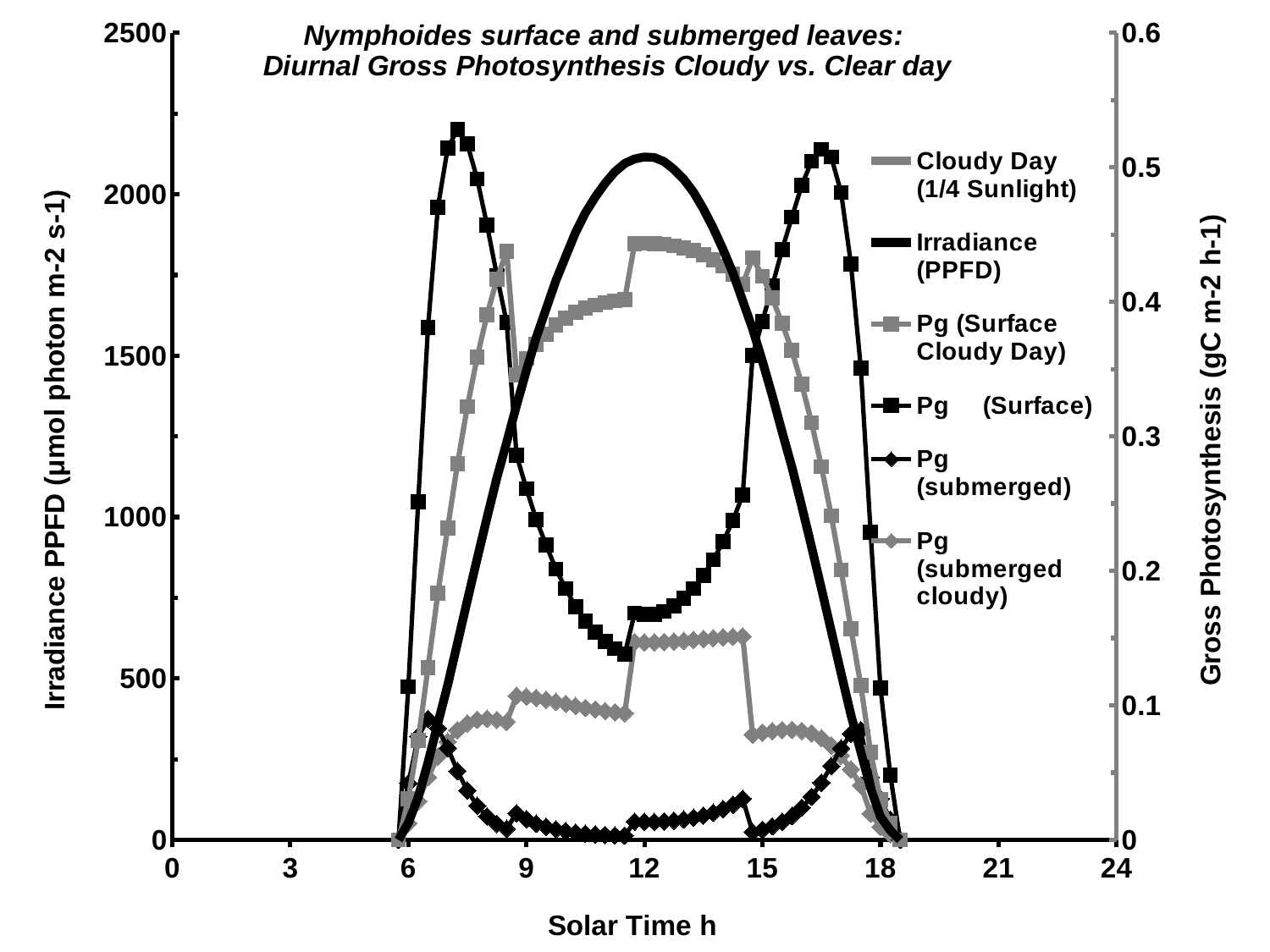
Is the peak value of the Pg (Surface) series on the right axis greater or less than 0.5? greater Is the peak value of the Cloudy Day (1/4 Sunlight) series greater or less than 1000? less At 12 h, which is higher: Pg (Surface Cloudy Day) or Pg (Surface)? Pg (Surface Cloudy Day) Between 12 h and 18 h, does the Irradiance (PPFD) series rise or fall? fall Is the value of Pg (submerged) at 10.5 h greater or less than 0.1? less What kind of chart is shown on the slide? line chart How many series does the legend list? 6 What is the title of the chart? Nymphoides surface and submerged leaves: Diurnal Gross Photosynthesis Cloudy vs. Clear day What is the label of the x axis? Solar Time h Which Pg series reaches the highest value on the right axis? Pg (Surface)